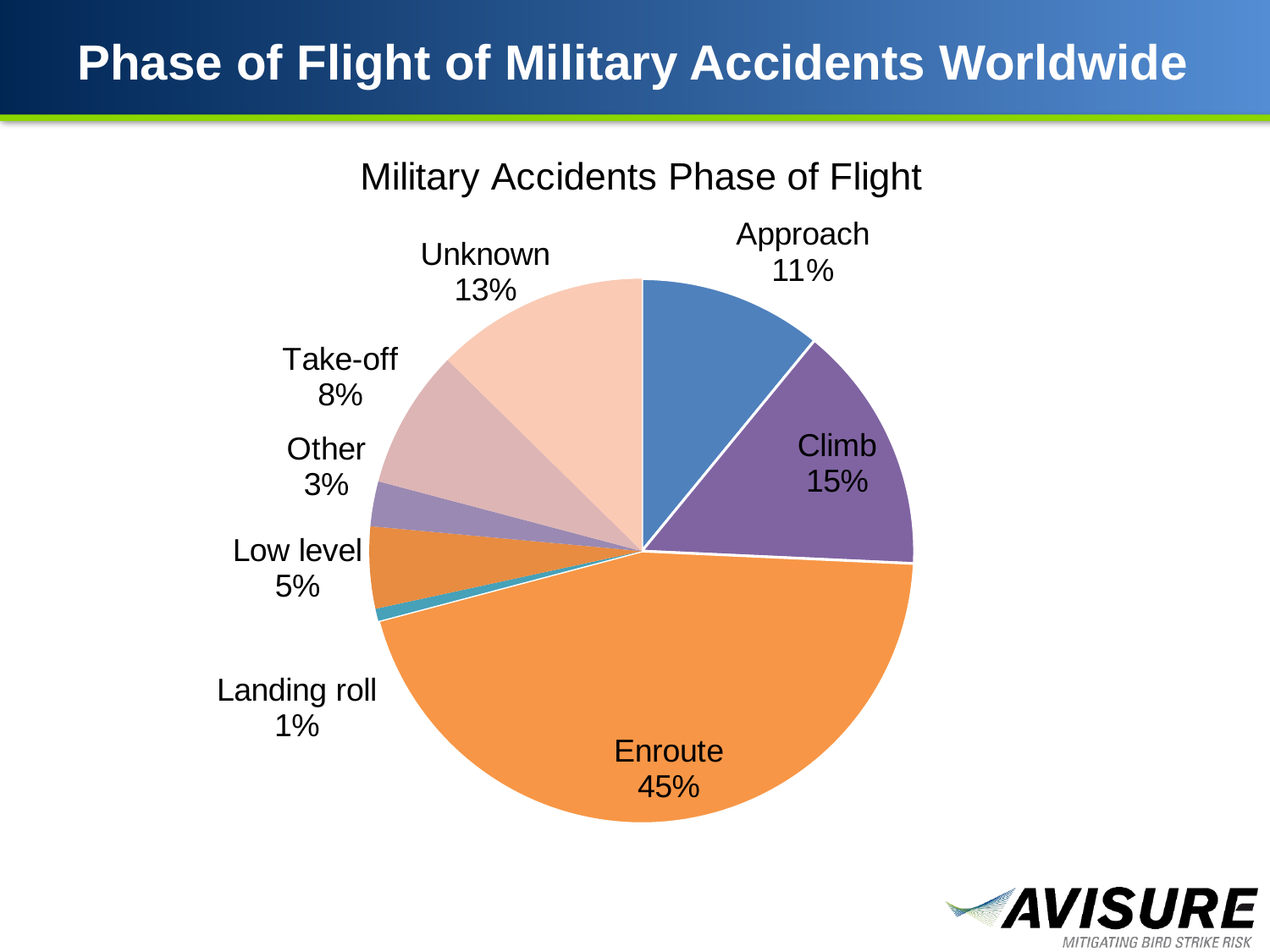
What is the difference in percentage points between Enroute and Unknown? 32 What share of military accidents occurred during the Enroute phase? 45% What percentage is shown for the Climb phase? 15% How many categories are shown in the pie chart? 8 Which phase of flight has the smallest share of military accidents? Landing roll What is the difference in percentage points between Climb and Approach? 4 Which has a larger share, Take-off or Low level? Take-off Which phase of flight has the largest share of military accidents? Enroute What type of chart is shown on the slide? pie chart What percentage is shown for Landing roll? 1% What percentage is shown for the Unknown category? 13% What is the title of the chart? Military Accidents Phase of Flight